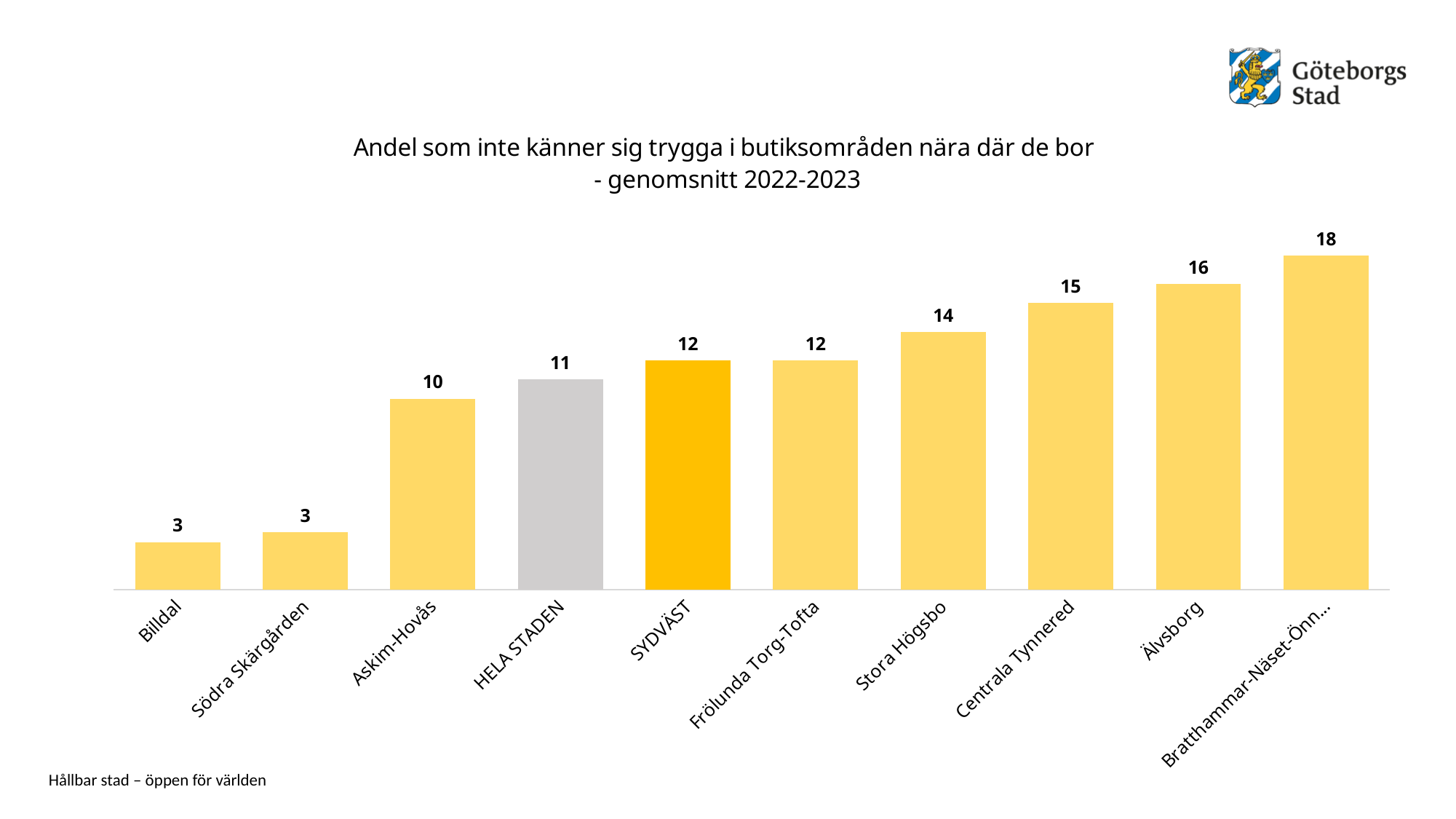
What is the value for HELA STADEN? 11 How many categories are shown in the chart? 10 Which has a larger value, SYDVÄST or Älvsborg? Älvsborg What is the value for Askim-Hovås? 10 What is the highest value shown in the chart? 18 What is the lowest value shown in the chart? 3 What is the difference between the values for Stora Högsbo and Billdal? 11 What kind of chart is shown on the slide? Bar chart What is the value for Centrala Tynnered? 15 What is the value for Älvsborg? 16 Do the values generally rise or fall from left to right along the x axis? Rise Which bar is coloured grey? HELA STADEN